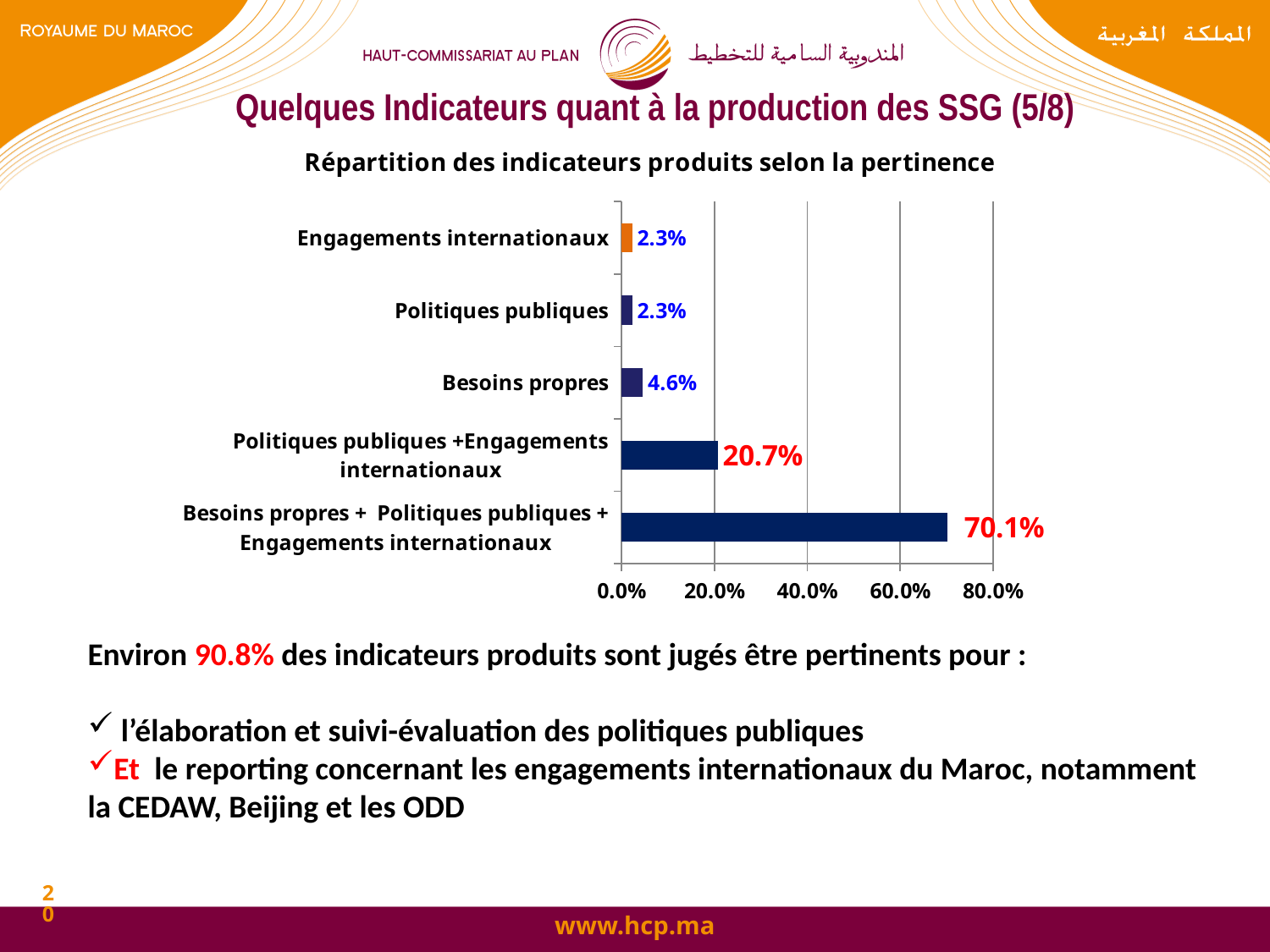
Which category has the highest value? Besoins propres + Politiques publiques + Engagements internationaux What is the difference between the values for "Besoins propres" and "Politiques publiques"? 2.3% Is the value for "Politiques publiques +Engagements internationaux" greater or less than 40.0%? less What is the value for "Engagements internationaux"? 2.3% What is the value for "Politiques publiques +Engagements internationaux"? 20.7% What is the value for "Besoins propres"? 4.6% Which is larger, the value for "Besoins propres" or the value for "Politiques publiques"? Besoins propres What is the difference between the values for "Besoins propres + Politiques publiques + Engagements internationaux" and "Politiques publiques +Engagements internationaux"? 49.4% What kind of chart is shown on the slide? bar chart How many categories are shown in the chart? 5 What is the title of the chart? Répartition des indicateurs produits selon la pertinence What is the value for "Besoins propres + Politiques publiques + Engagements internationaux"? 70.1%